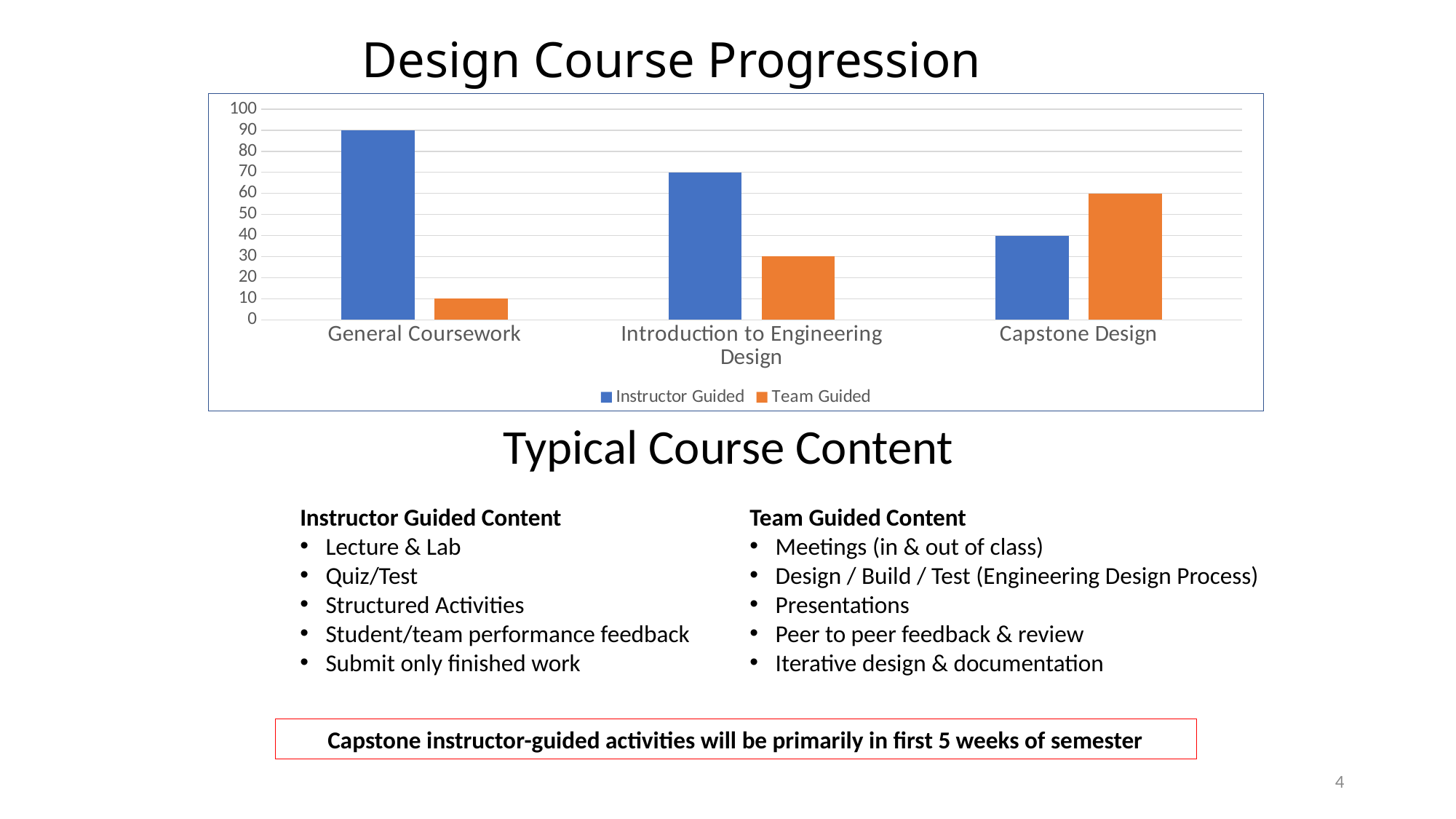
What is the difference between the Instructor Guided and Team Guided values for Introduction to Engineering Design? 40 What is the Team Guided value for Introduction to Engineering Design? 30 Which category has the highest Instructor Guided value? General Coursework What colour are the Team Guided bars? orange What kind of chart is shown on the slide? bar chart What is the Team Guided value for Capstone Design? 60 How many series does the legend list? 2 How many categories are shown on the x axis? 3 Which category has the lowest Team Guided value? General Coursework Do the Team Guided values rise or fall from General Coursework to Capstone Design? rise For Capstone Design, which is larger: Instructor Guided or Team Guided? Team Guided What is the Instructor Guided value for General Coursework? 90